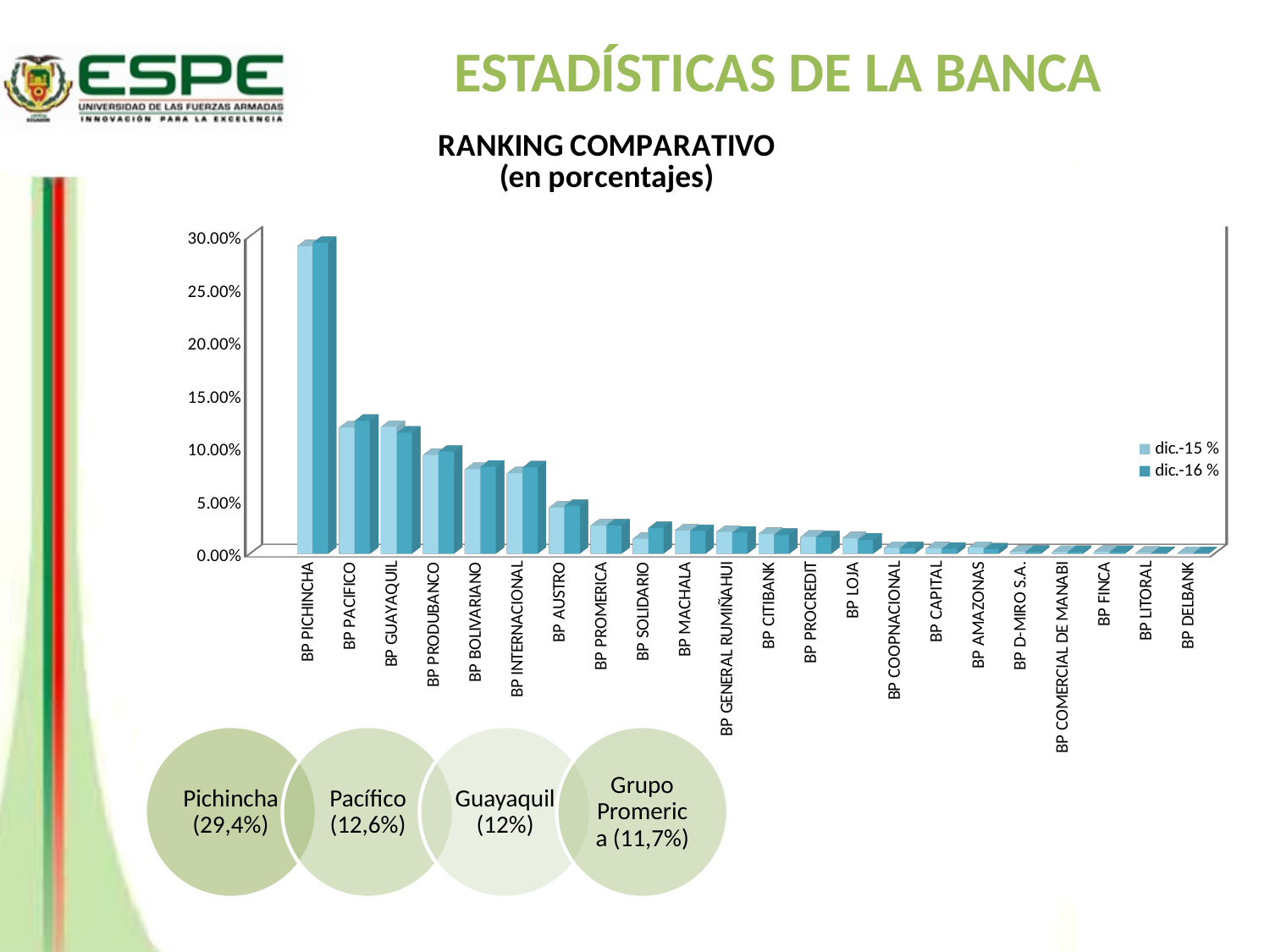
What is the title of the chart? RANKING COMPARATIVO (en porcentajes) Which bank has the highest value in the chart? BP PICHINCHA Which is larger, the dic.-16 % value for BP PRODUBANCO or for BP AUSTRO? BP PRODUBANCO Do the values generally rise or fall moving from left to right along the x axis? fall How many banks (categories) are shown on the x axis? 22 Is the dic.-16 % value for BP PICHINCHA greater or less than 25.00%? greater Is the dic.-16 % value for BP PACIFICO greater or less than 10.00%? greater What kind of chart is shown on the slide? bar chart How many series does the legend list? 2 What are the two series named in the legend? dic.-15 % and dic.-16 % Is the dic.-15 % value for BP AUSTRO greater or less than 10.00%? less